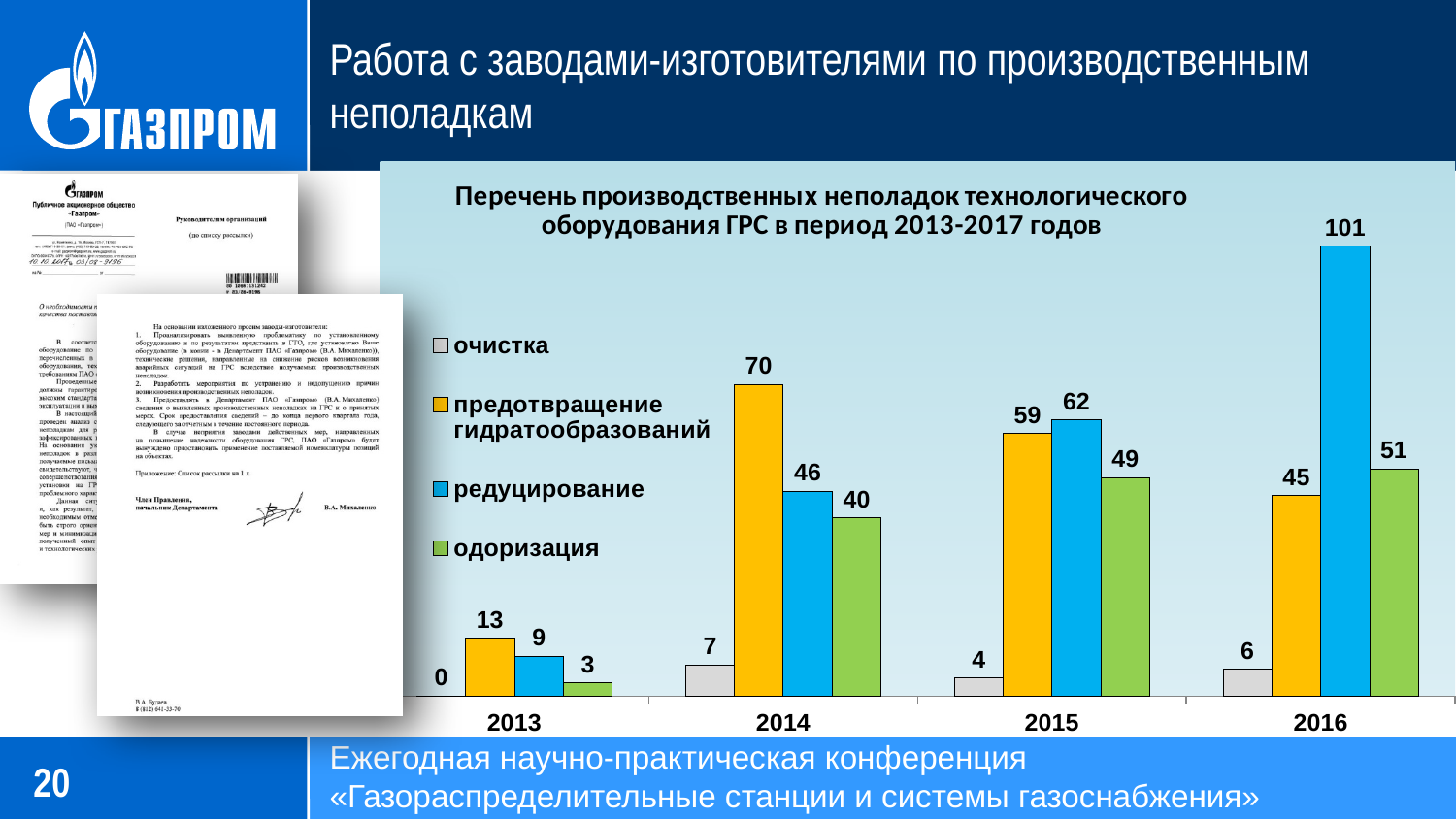
What is the title of the chart? Перечень производственных неполадок технологического оборудования ГРС в период 2013-2017 годов Which is larger in 2015: предотвращение гидратообразований or редуцирование? редуцирование What is the value for одоризация in 2015? 49 How many series does the legend list? 4 What type of chart is shown on the slide? Bar chart What is the value for редуцирование in 2016? 101 In which year is the value for одоризация the lowest? 2013 What is the difference between редуцирование and предотвращение гидратообразований in 2016? 56 How many years (categories) are shown on the x axis? 4 What is the value for очистка in 2013? 0 What is the value for предотвращение гидратообразований in 2014? 70 In which year is the value for редуцирование the highest? 2016